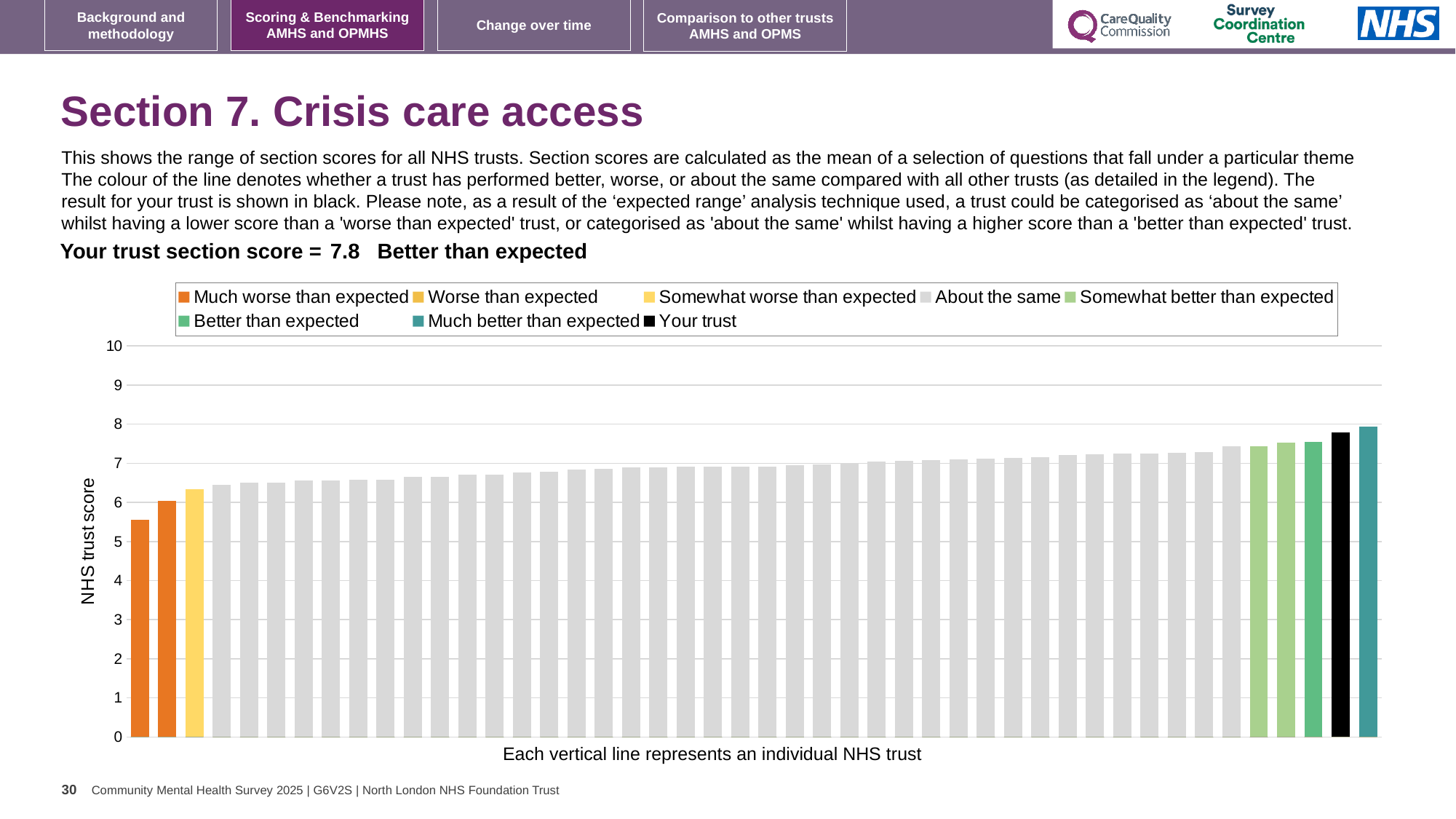
How many bars are coloured as 'Much worse than expected'? 2 Which category is your trust placed in for this section? Better than expected What colour is the bar representing your trust? black What kind of chart is shown on the slide? bar chart Is the value of the lowest bar greater or less than 6? less What is the label on the y axis of the chart? NHS trust score Do the bar values rise or fall from left to right along the x axis? rise Is the value of the highest bar greater or less than 7? greater How many entries does the chart legend list? 8 What is the section score for your trust? 7.8 Is the value for your trust greater or less than 7? greater Which is larger, the value for your trust or the value of the leftmost bar? your trust